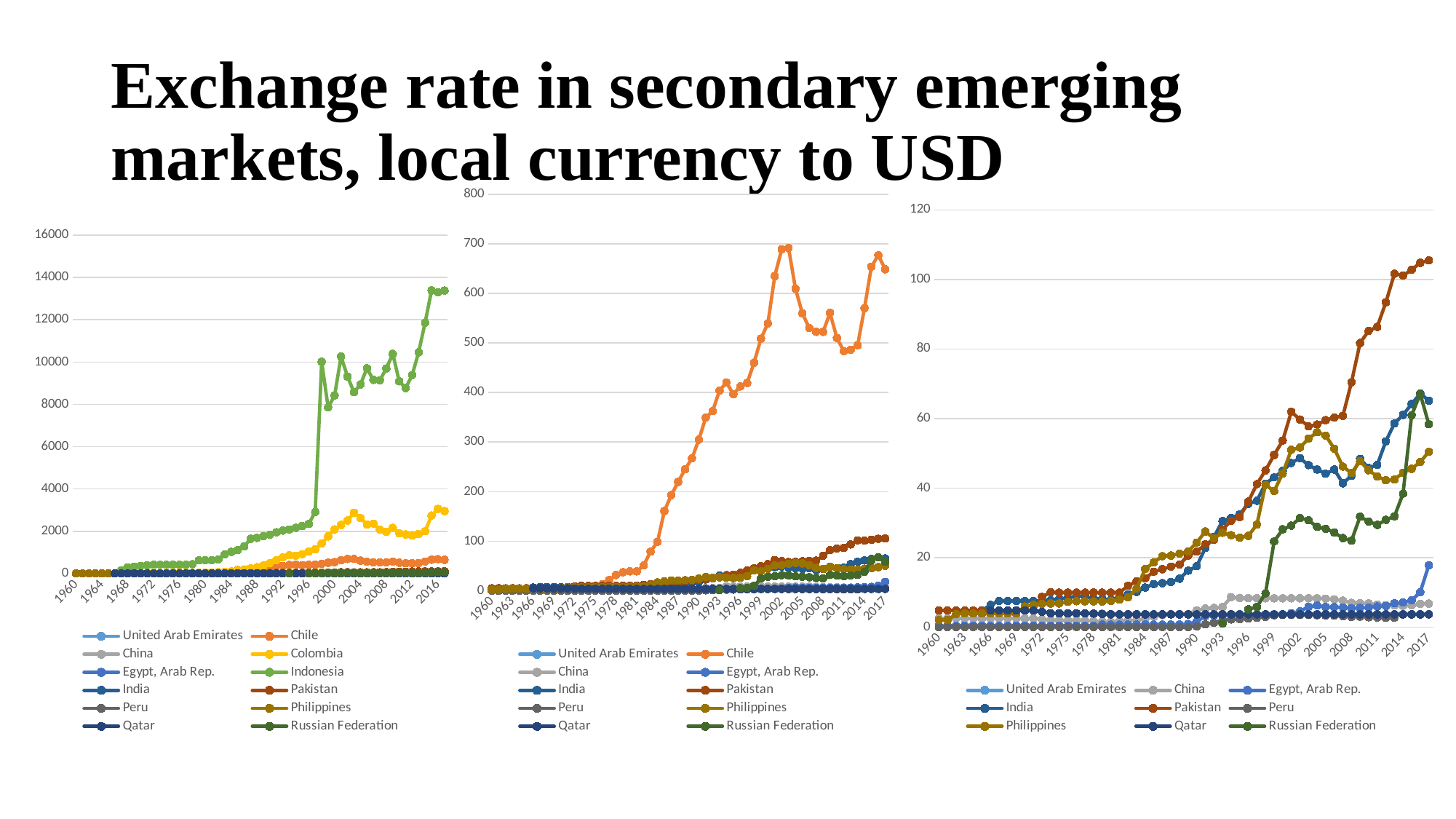
In the middle chart, is the value for Chile in 2017 greater or less than 600? greater In the right chart, which is higher in 2017, Pakistan or India? Pakistan In the left chart, is the value for Indonesia in 2016 greater or less than 12000? greater How many series does the legend of the left chart list? 12 What kind of chart is the left chart on the slide? line chart How many series does the legend of the right chart list? 9 In the right chart, which series has the highest value in 2017? Pakistan How many series does the legend of the middle chart list? 10 In the right chart, does the Pakistan series generally rise or fall from 1960 to 2017? rise In the left chart, which series reaches the highest value? Indonesia In the right chart, is the value for Pakistan in 2017 greater or less than 100? greater In the middle chart, which series reaches the highest value? Chile